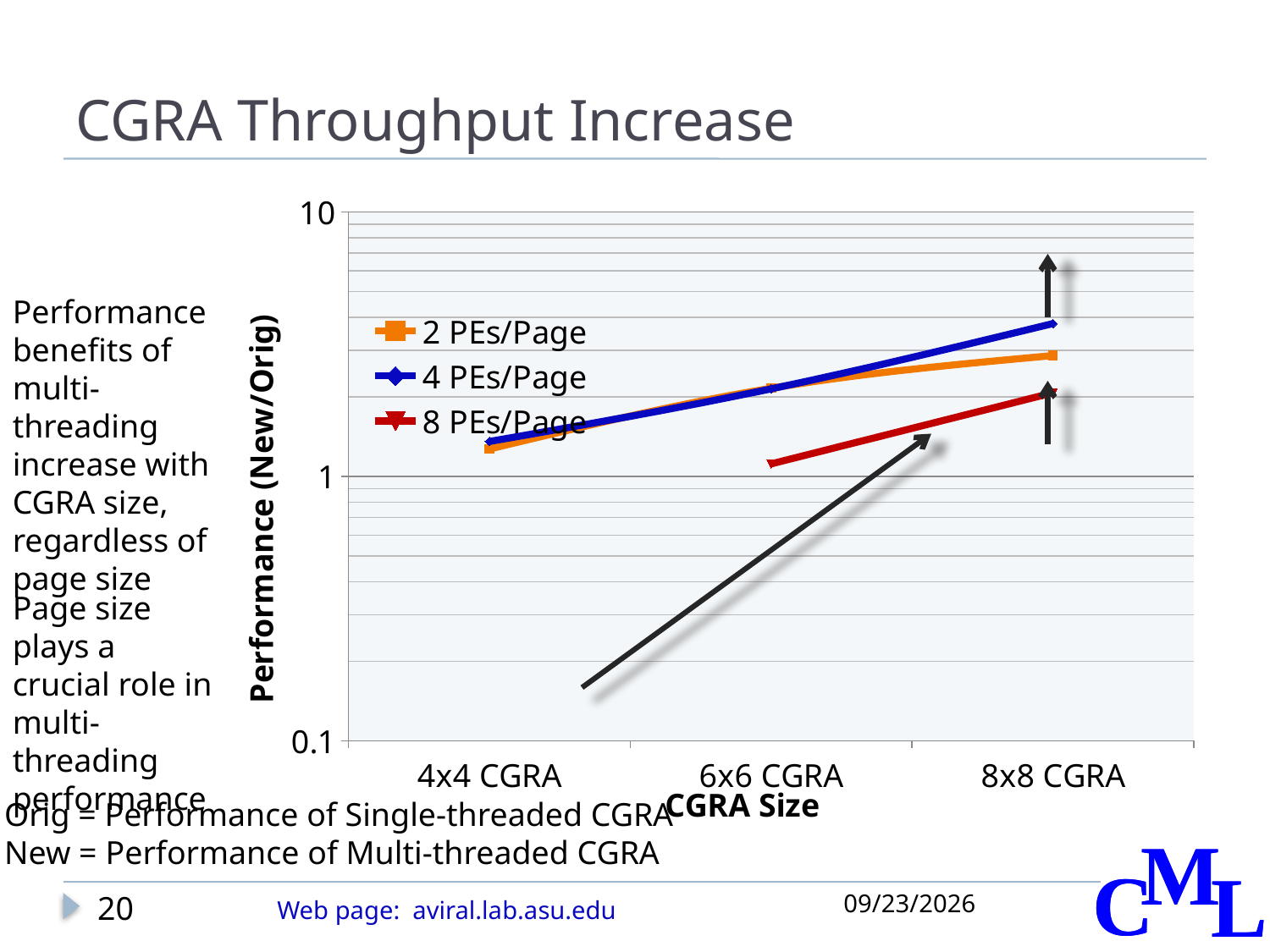
At 8x8 CGRA, which is larger: the value for 2 PEs/Page or the value for 4 PEs/Page? 4 PEs/Page How many series does the chart legend list? 3 Is the value for 4 PEs/Page at 8x8 CGRA greater or less than 10? less How many CGRA size categories are shown on the x axis? 3 What is the title of the chart's y axis? Performance (New/Orig) Does the performance for 4 PEs/Page rise or fall as CGRA size increases from 4x4 to 8x8? rise At 8x8 CGRA, which is larger: the value for 2 PEs/Page or the value for 8 PEs/Page? 2 PEs/Page What kind of chart is shown on the slide? line chart Which series has the lowest value at 8x8 CGRA? 8 PEs/Page Which series has the highest value at 8x8 CGRA? 4 PEs/Page Is the value for 4 PEs/Page at 8x8 CGRA greater or less than 1? greater What is the title of the chart's x axis? CGRA Size